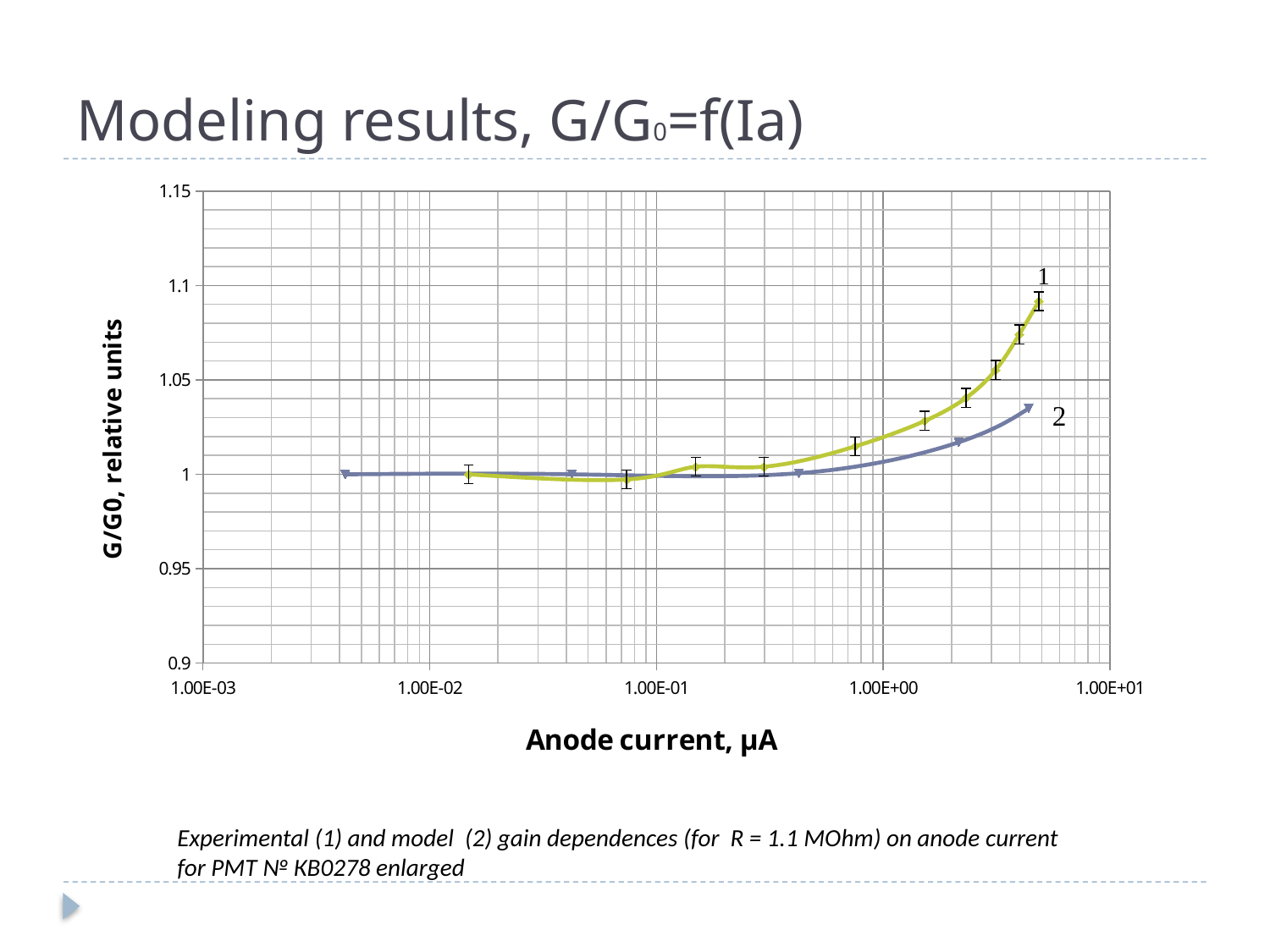
What is the title of the y axis? G/G0, relative units Is the value of curve 2 at its highest anode current greater or less than 1? greater Is the value of curve 1 at its highest anode current greater or less than 1.05? greater What kind of chart is shown on the slide? line chart At the highest anode currents shown, which curve has the larger G/G0 value, curve 1 or curve 2? curve 1 Is the value of curve 2 at its highest anode current greater or less than 1.05? less What is the highest tick value shown on the y axis? 1.15 How many curves are plotted on the chart? 2 Do the G/G0 values of curve 1 rise or fall as anode current increases above 1.00E+00 μA? rise What is the title of the x axis? Anode current, μA